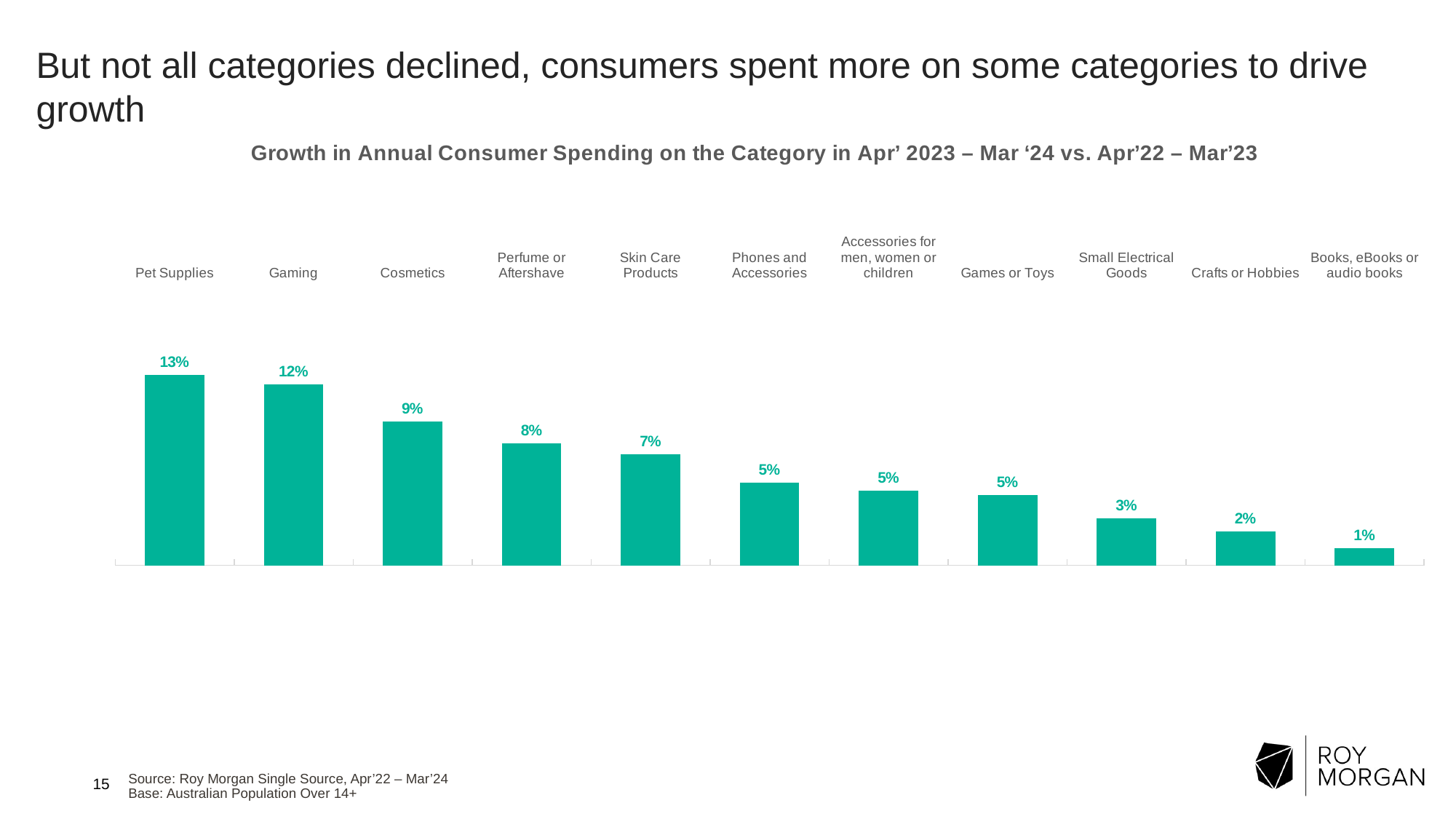
What kind of chart is shown on the slide? Bar chart Do the values rise or fall moving from left to right along the x axis? Fall What is the growth value shown for Small Electrical Goods? 3% Which category has the highest growth in annual consumer spending? Pet Supplies How many categories are shown in the chart? 11 What is the title of the chart? Growth in Annual Consumer Spending on the Category in Apr' 2023 – Mar '24 vs. Apr'22 – Mar'23 What is the growth in annual consumer spending for Pet Supplies? 13% What is the difference between the growth for Perfume or Aftershave and the growth for Crafts or Hobbies? 6% Which has a higher growth value, Cosmetics or Games or Toys? Cosmetics What is the difference between the growth for Gaming and the growth for Cosmetics? 3% Which category has the lowest growth in annual consumer spending? Books, eBooks or audio books What is the growth value shown for Skin Care Products? 7%